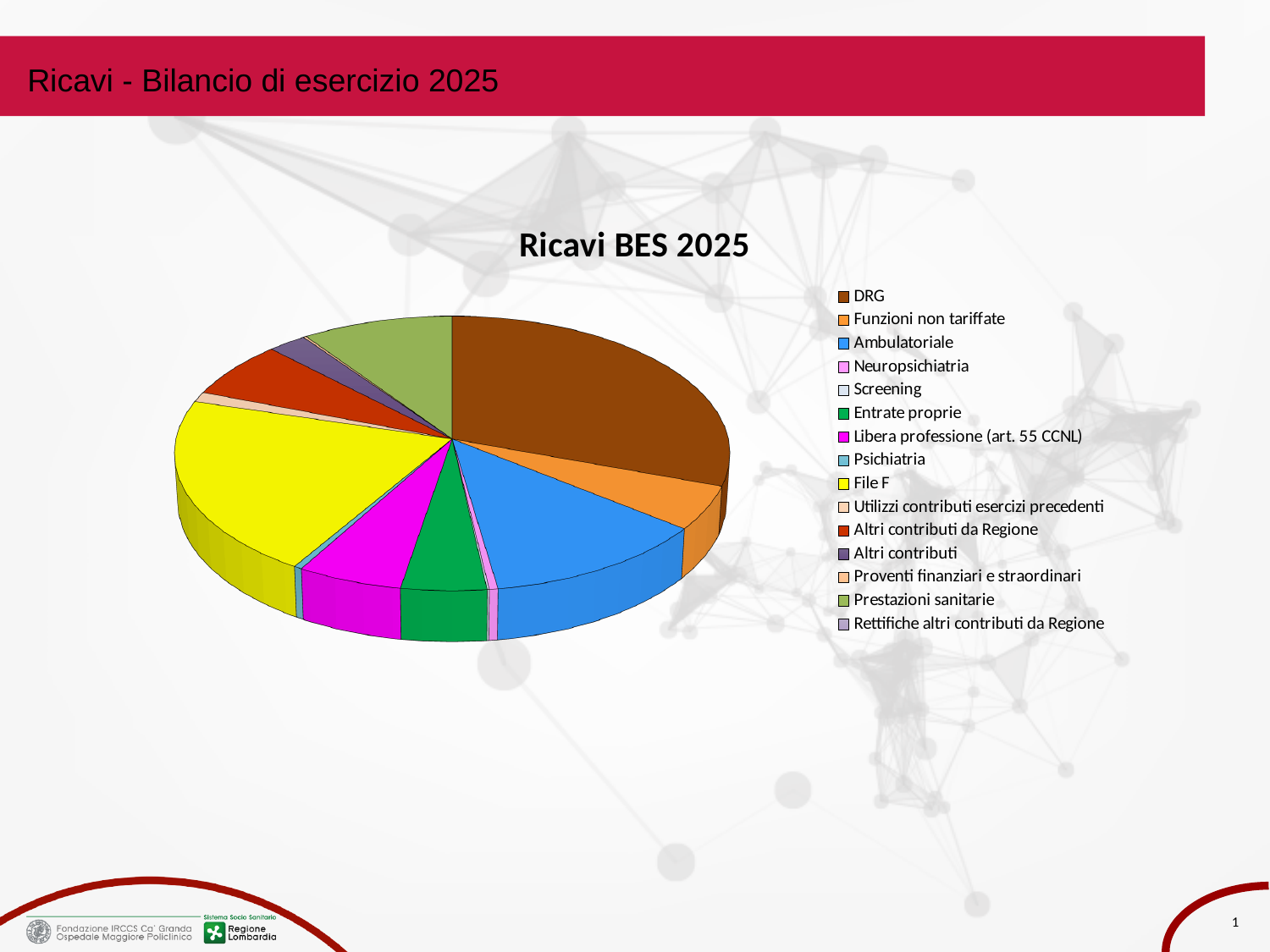
Which slice is larger, Prestazioni sanitarie or Altri contributi? Prestazioni sanitarie Which category has the largest slice of the pie? DRG How many categories does the chart's legend list? 15 What is the title of the chart? Ricavi BES 2025 What colour is the File F slice in the chart? yellow Which slice is larger, File F or Funzioni non tariffate? File F Which slice is larger, Altri contributi da Regione or Proventi finanziari e straordinari? Altri contributi da Regione What kind of chart is shown on the slide? pie chart